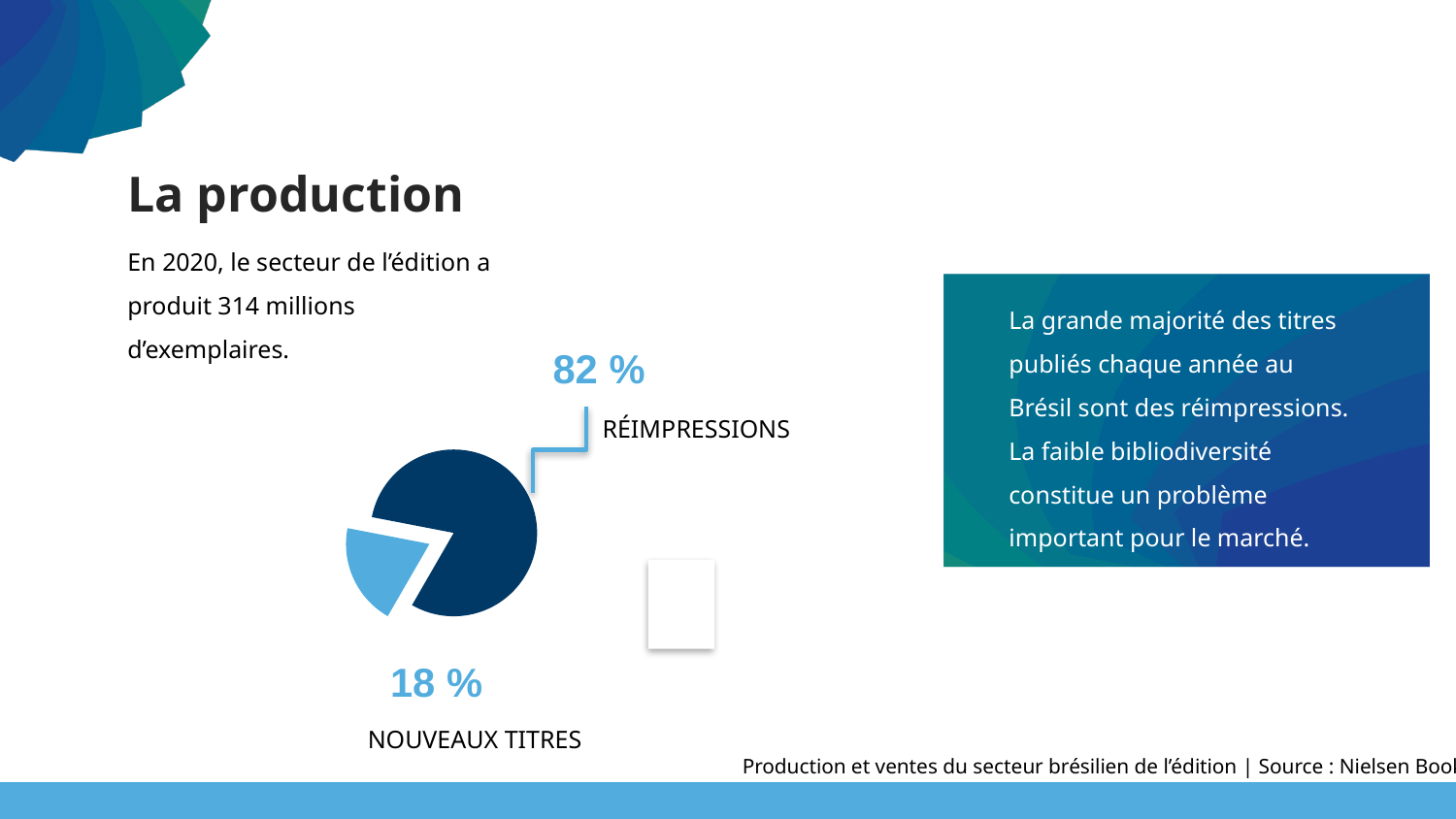
How many slices does the pie chart have? 2 Which slice of the pie is drawn in the darker blue colour? RÉIMPRESSIONS What is the difference in percentage points between the RÉIMPRESSIONS slice and the NOUVEAUX TITRES slice? 64 Which slice of the pie is pulled out (exploded) from the rest of the pie? NOUVEAUX TITRES Which slice of the pie is the smallest? NOUVEAUX TITRES What is the total of the two slices shown in the pie chart? 100 % What share of the pie is labelled NOUVEAUX TITRES? 18 % What share of the pie is labelled RÉIMPRESSIONS? 82 % Which slice of the pie is the largest? RÉIMPRESSIONS Which is larger, the share for RÉIMPRESSIONS or the share for NOUVEAUX TITRES? RÉIMPRESSIONS What kind of chart is shown on the slide? pie chart